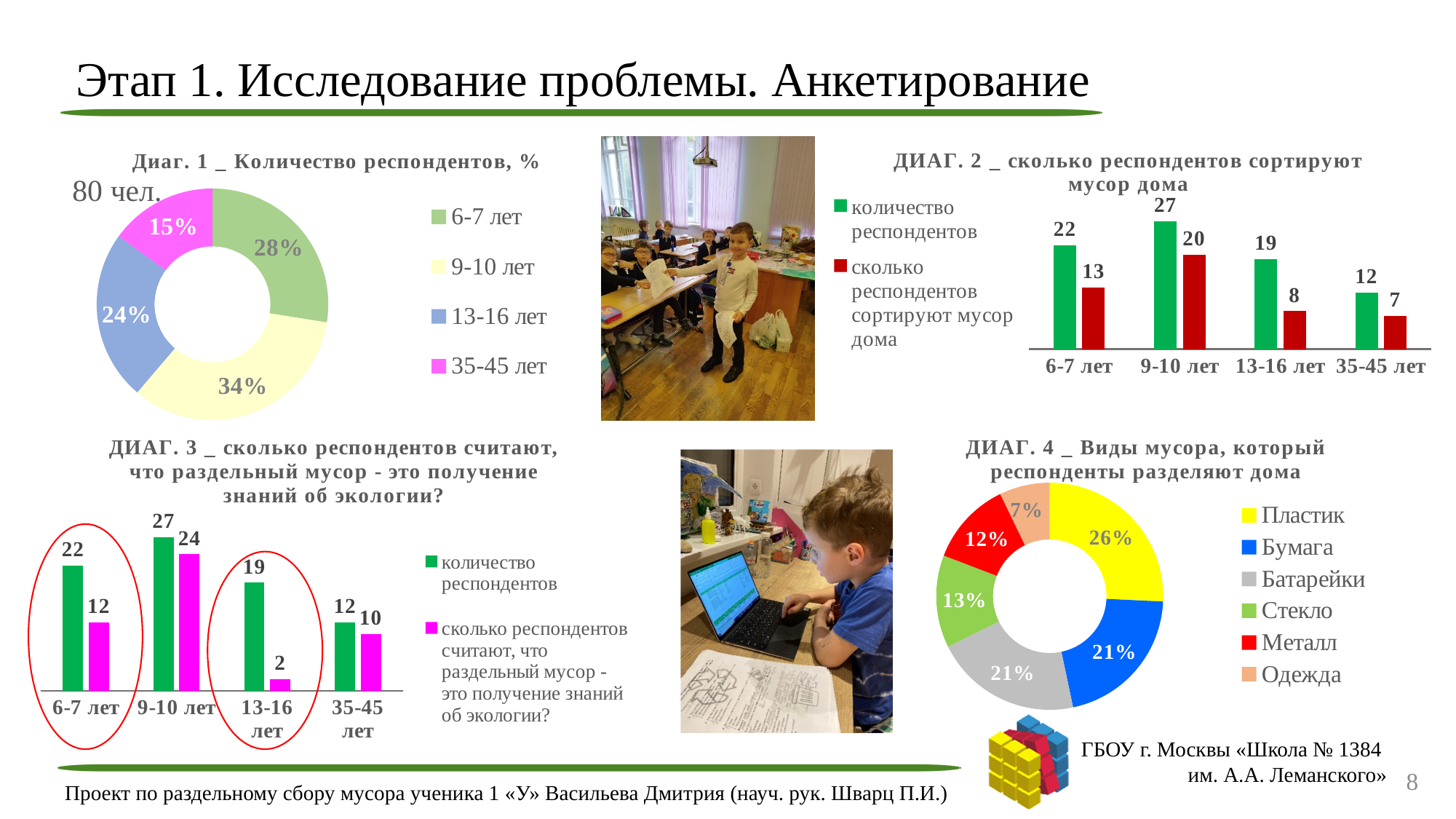
In Диаг. 2 (сколько респондентов сортируют мусор дома), how many respondents in the 9-10 лет group sort waste at home? 20 In Диаг. 3 (сколько респондентов считают, что раздельный мусор - это получение знаний об экологии?), which is larger for the 6-7 лет group: the number of respondents or the number who think separate waste is gaining ecological knowledge? Number of respondents (22) In Диаг. 2 (сколько респондентов сортируют мусор дома), which age group has the highest number of respondents? 9-10 лет In Диаг. 3 (сколько респондентов считают, что раздельный мусор - это получение знаний об экологии?), how many age groups are shown on the x axis? 4 In Диаг. 1 (Количество респондентов, %), what share of respondents are in the 9-10 лет group? 34% In Диаг. 1 (Количество респондентов, %), which age group has the smallest share? 35-45 лет What kind of chart is Диаг. 1 (Количество респондентов, %)? Pie (donut) chart How many series does the legend of Диаг. 2 (сколько респондентов сортируют мусор дома) list? 2 In Диаг. 3 (сколько респондентов считают, что раздельный мусор - это получение знаний об экологии?), how many respondents in the 13-16 лет group think separate waste collection is gaining knowledge about ecology? 2 In Диаг. 2 (сколько респондентов сортируют мусор дома), what is the difference between the number of respondents and the number who sort waste at home for the 13-16 лет group? 11 In Диаг. 4 (Виды мусора, который респонденты разделяют дома), which type of waste has the largest share? Пластик In Диаг. 4 (Виды мусора, который респонденты разделяют дома), what share is Стекло? 13%